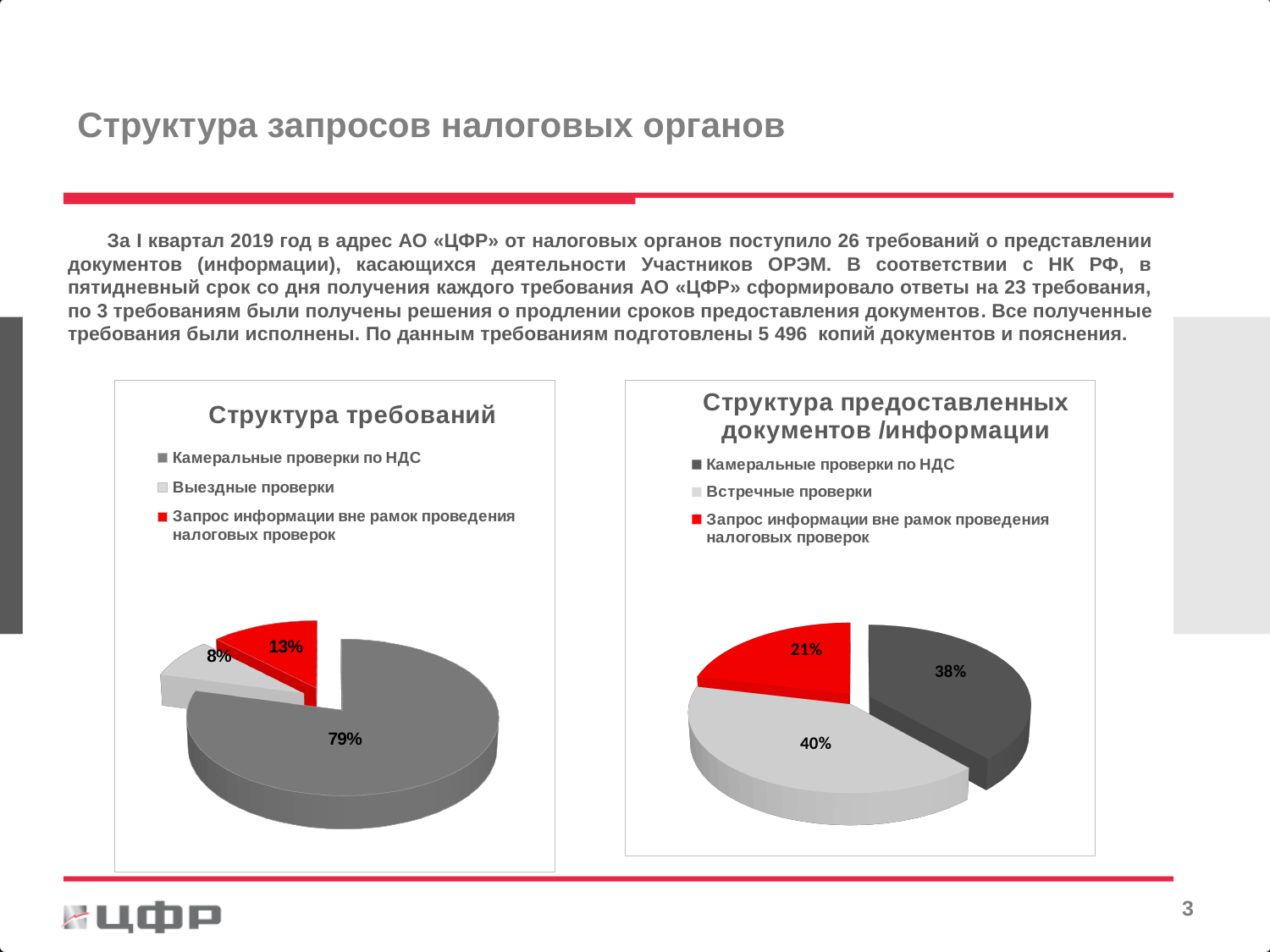
In the chart titled "Структура требований", which category has the smallest slice? Выездные проверки How many categories does the legend of the chart titled "Структура предоставленных документов /информации" list? 3 What kind of chart is the chart titled "Структура требований"? Pie chart In the chart titled "Структура предоставленных документов /информации", what share is shown for Запрос информации вне рамок проведения налоговых проверок? 21% In the chart titled "Структура предоставленных документов /информации", what share is shown for Камеральные проверки по НДС? 38% In the chart titled "Структура предоставленных документов /информации", which category has the smallest slice? Запрос информации вне рамок проведения налоговых проверок In the chart titled "Структура требований", what share is shown for Выездные проверки? 8% In the chart titled "Структура требований", which category has the largest slice? Камеральные проверки по НДС In the chart titled "Структура требований", what is the difference between the shares for Камеральные проверки по НДС and Запрос информации вне рамок проведения налоговых проверок? 66% In the chart titled "Структура требований", what share is shown for Запрос информации вне рамок проведения налоговых проверок? 13% In the chart titled "Структура требований", what share is shown for Камеральные проверки по НДС? 79% In the chart titled "Структура предоставленных документов /информации", what share is shown for Встречные проверки? 40%